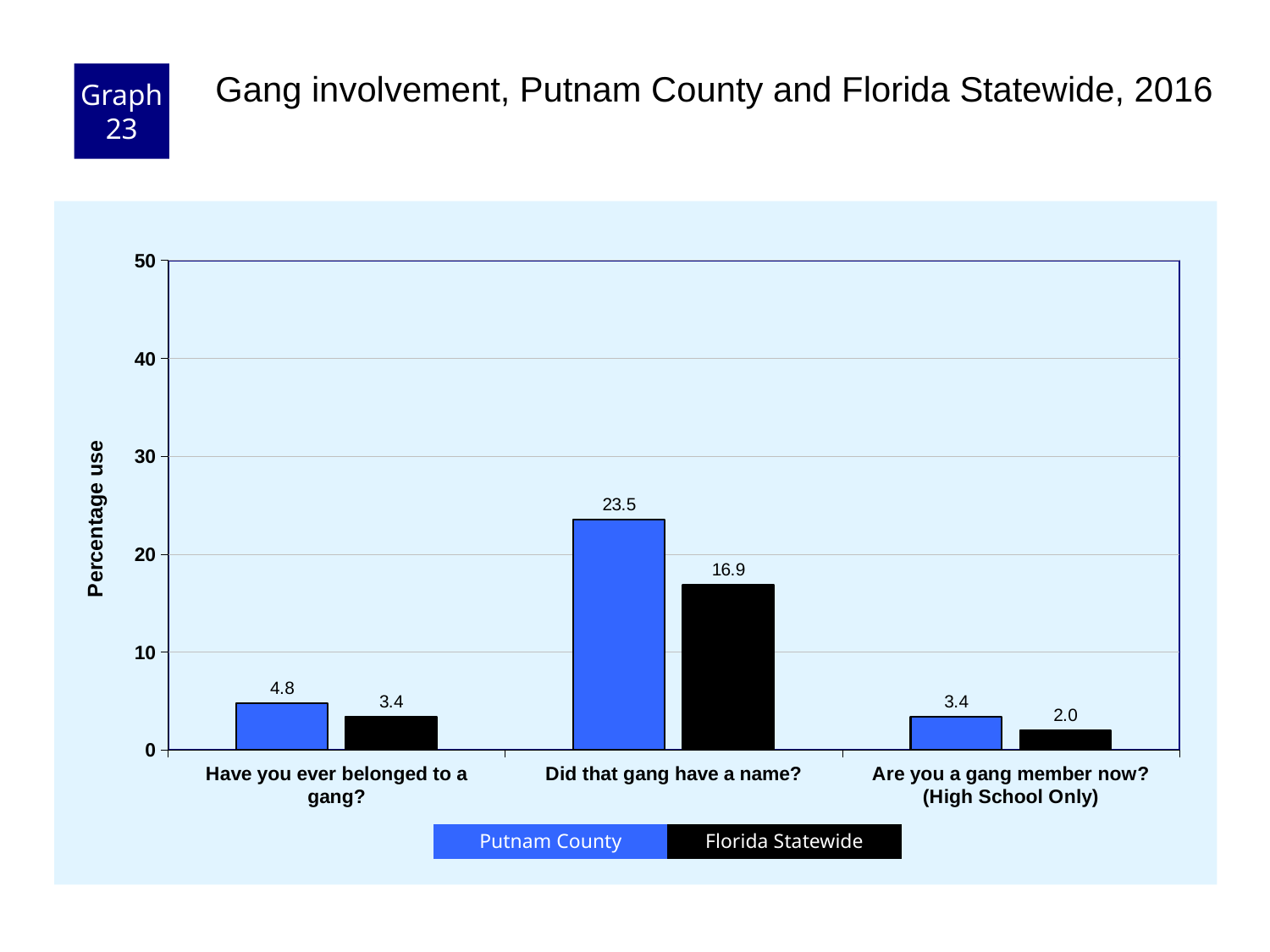
What is the difference between the Putnam County and Florida Statewide values for "Did that gang have a name?"? 6.6 What is the Florida Statewide value for "Are you a gang member now? (High School Only)"? 2.0 How many questions (categories) are shown on the x axis? 3 What is the Florida Statewide value for "Have you ever belonged to a gang?"? 3.4 Which question has the highest Putnam County value? Did that gang have a name? Which is larger for "Have you ever belonged to a gang?": Putnam County or Florida Statewide? Putnam County What kind of chart is shown on the slide? bar chart How many series does the legend list? 2 Is the Putnam County value for "Did that gang have a name?" greater or less than 20? greater What is the Putnam County value for "Did that gang have a name?"? 23.5 What is the label on the y axis? Percentage use Which question has the lowest Florida Statewide value? Are you a gang member now? (High School Only)